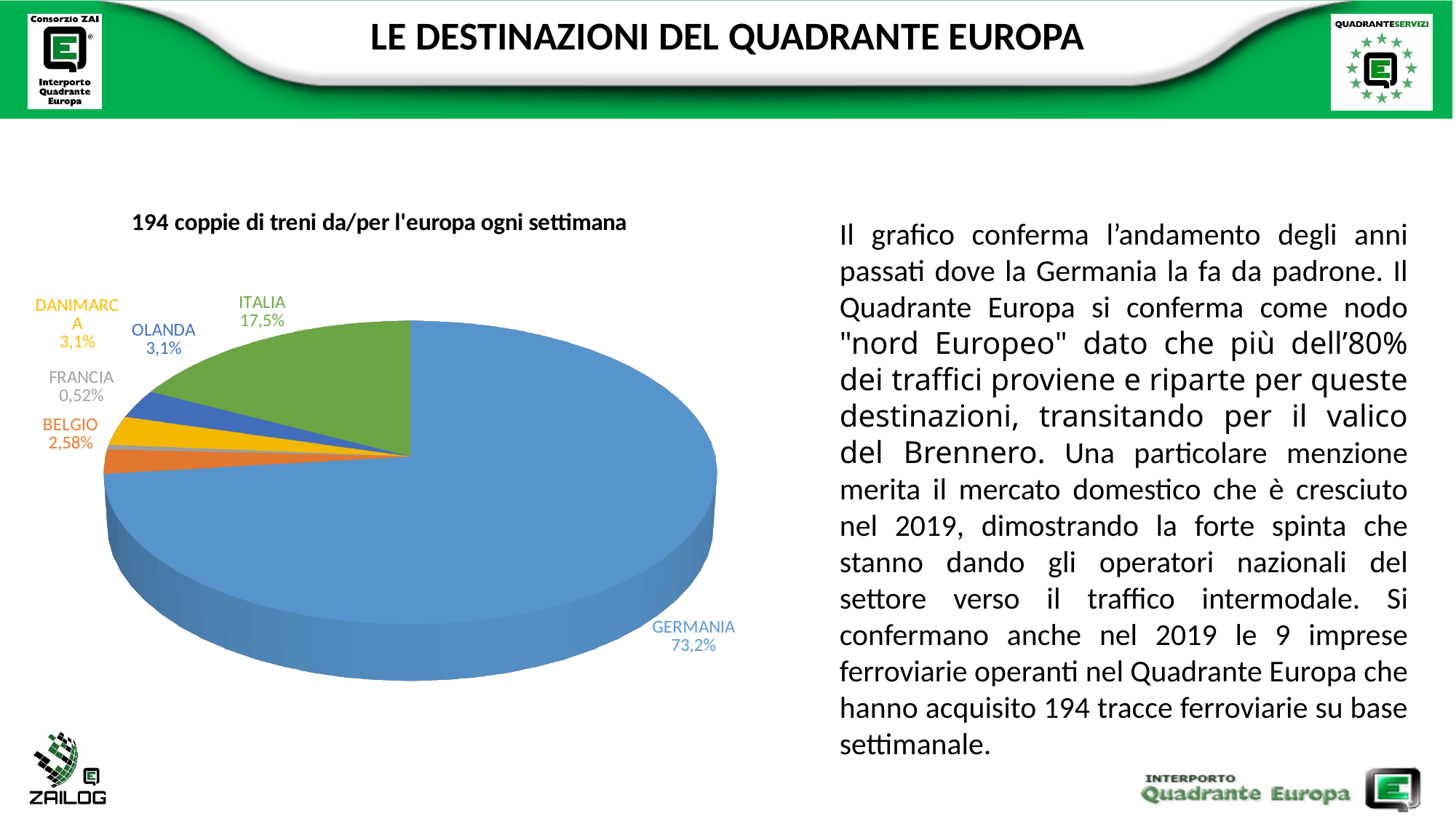
Which is larger, the share for OLANDA or the share for BELGIO? OLANDA What share of the pie does GERMANIA have? 73,2% How many destinations are shown in the pie chart? 6 What is the value shown for BELGIO? 2,58% Which destination has the smallest slice of the pie? FRANCIA What colour is the GERMANIA slice? Blue What is the difference in percentage points between GERMANIA and ITALIA? 55,7 What kind of chart is shown on the slide? Pie chart What share of the pie does ITALIA have? 17,5% What is the title of the chart? 194 coppie di treni da/per l'europa ogni settimana What is the value shown for FRANCIA? 0,52% Which destination has the largest slice of the pie? GERMANIA